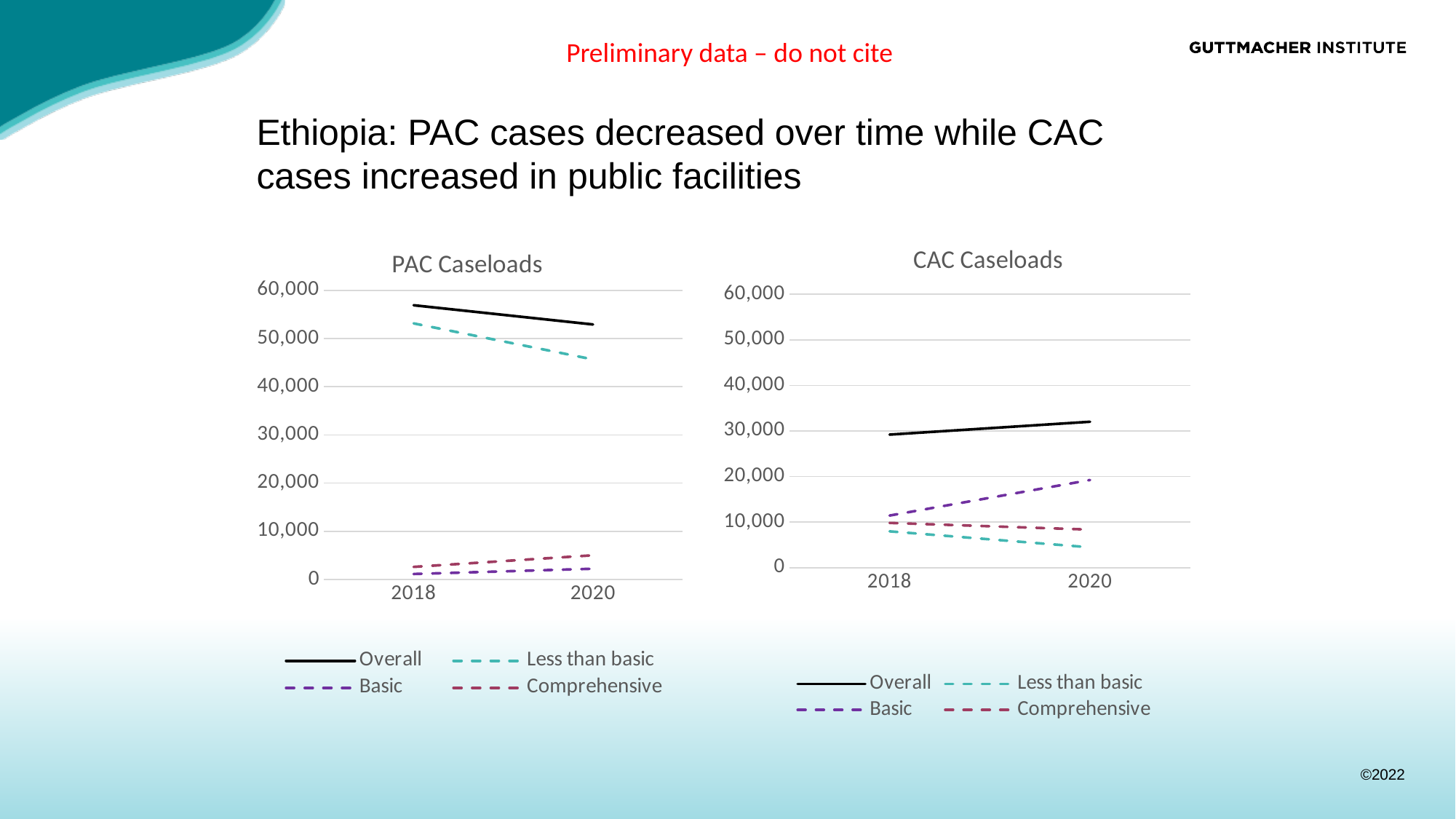
How many years are shown on the x axis of the PAC Caseloads chart? 2 In the CAC Caseloads chart, which is larger in 2020: Basic or Comprehensive? Basic In the CAC Caseloads chart, does the Basic series rise or fall from 2018 to 2020? rise In the PAC Caseloads chart, is the Overall value for 2018 greater or less than 50,000? greater What type of chart is the PAC Caseloads chart? line chart In the CAC Caseloads chart, does the Less than basic series rise or fall from 2018 to 2020? fall In the PAC Caseloads chart, does the Overall series rise or fall from 2018 to 2020? fall In the CAC Caseloads chart, is the Less than basic value for 2020 greater or less than 10,000? less How many series does the legend of the CAC Caseloads chart list? 4 In the PAC Caseloads chart, which series has the lowest values in 2018? Basic In the PAC Caseloads chart, is the Less than basic value for 2020 greater or less than 50,000? less